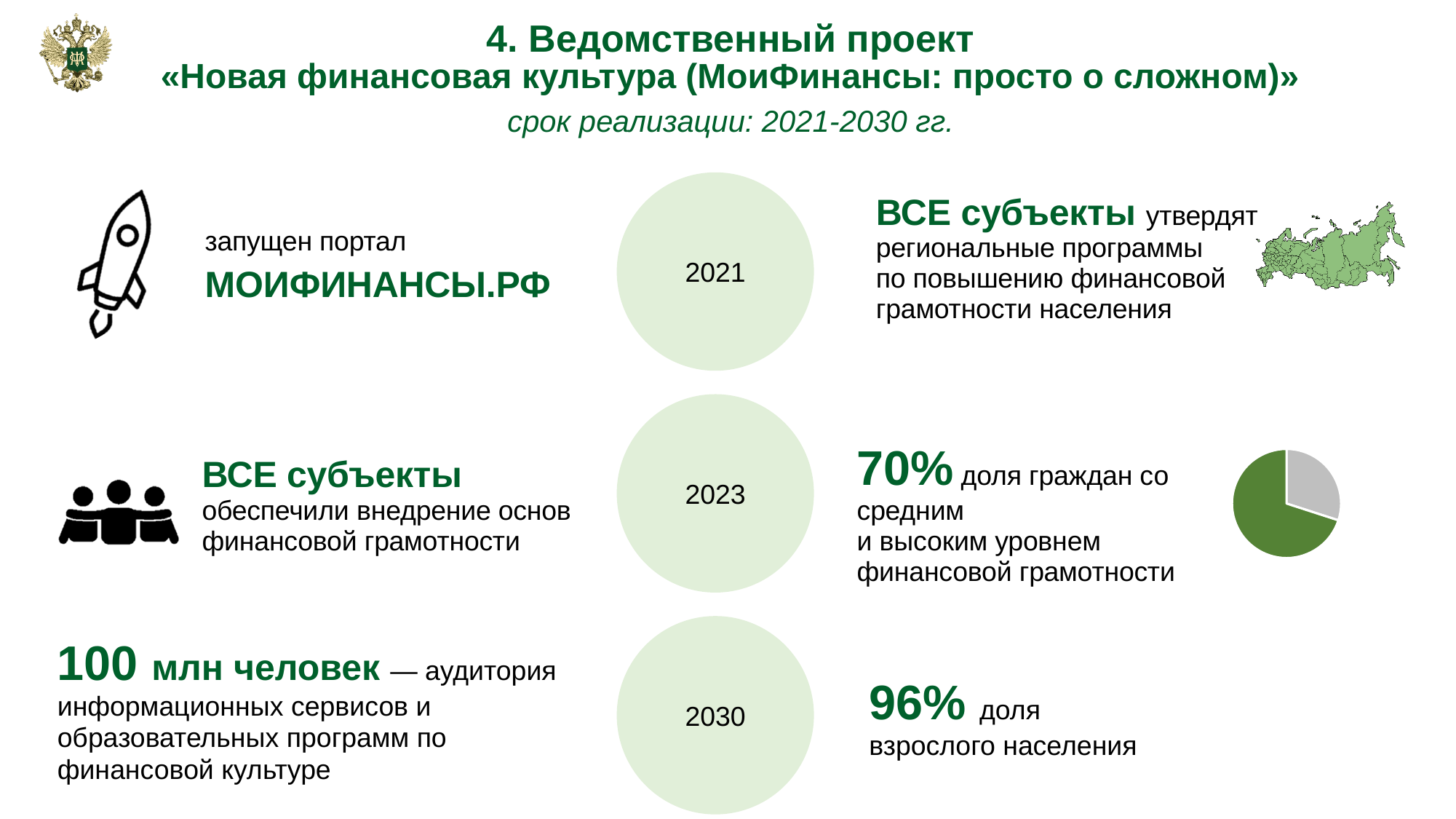
Is the green slice of the pie chart greater or less than 50% of the whole? greater How many slices does the pie chart on the slide have? 2 In the pie chart, which slice is larger, the green one or the grey one? green What share of the pie chart does the green slice represent, according to the figure printed beside it? 70% Which year milestone is the pie chart placed next to? 2023 What does the green slice of the pie chart represent, according to the text beside it? доля граждан со средним и высоким уровнем финансовой грамотности What share of the pie chart does the grey slice represent? 30% What kind of chart is shown next to the 2023 milestone on the right side of the slide? pie chart